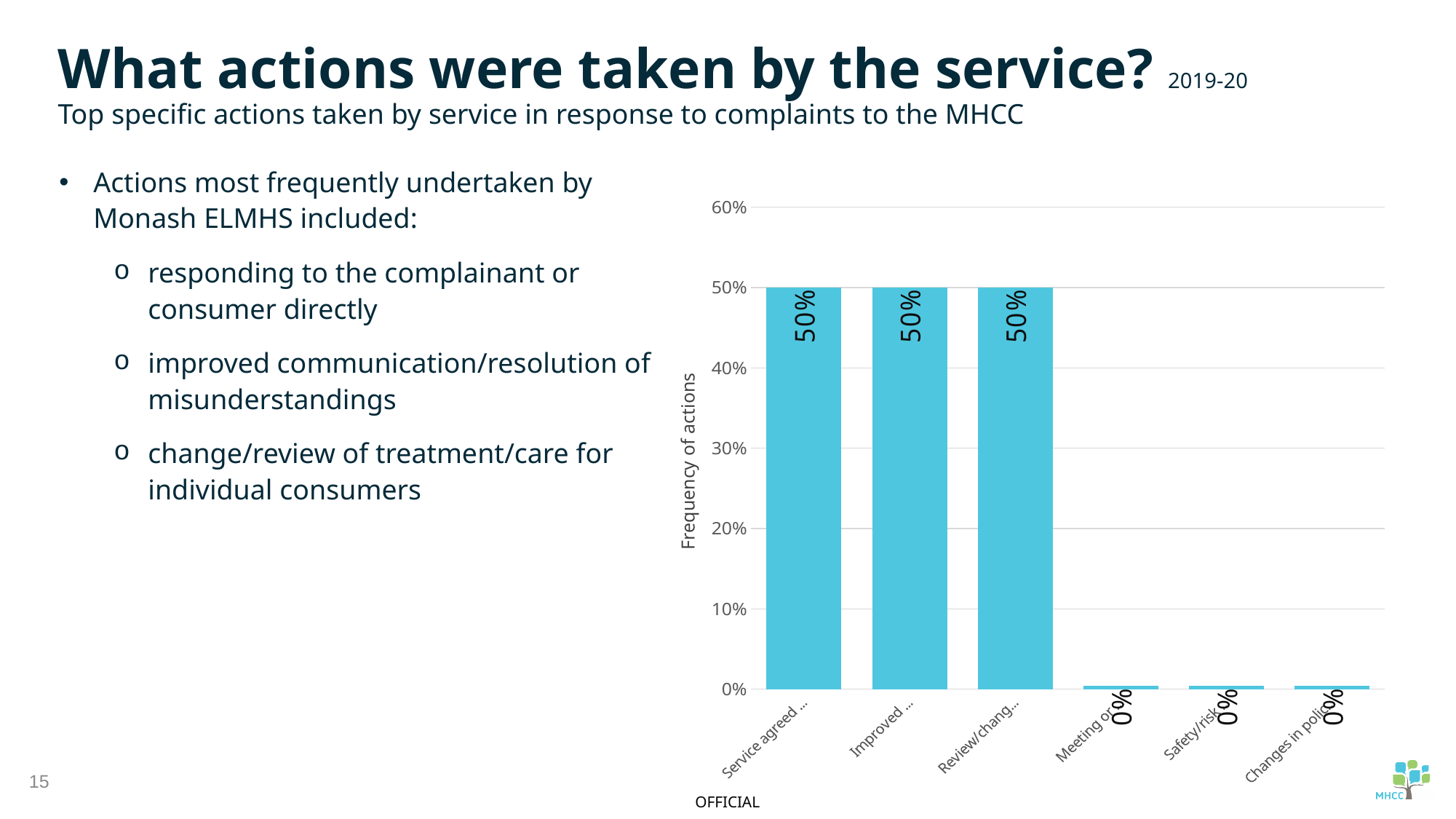
How many bars in the chart show a value of 50%? 3 What is the value of the first bar ("Service agreed ...") in the chart? 50% What is the value of the last bar ("Changes in polic...") in the chart? 0% Do the bar values rise or fall moving from left to right along the x axis? fall What is the difference between the value of the second bar ("Improved ...") and the fourth bar ("Meeting or...")? 50% What is the value of the fourth bar ("Meeting or...") in the chart? 0% Which is larger: the value of the first bar ("Service agreed ...") or the fifth bar ("Safety/risk...")? Service agreed ... Is the value for the third bar ("Review/chang...") greater or less than 40%? greater How many categories (bars) are plotted in the chart? 6 What is the title of the vertical axis of the chart? Frequency of actions How many bars in the chart show a value of 0%? 3 What kind of chart is shown on the slide? bar chart